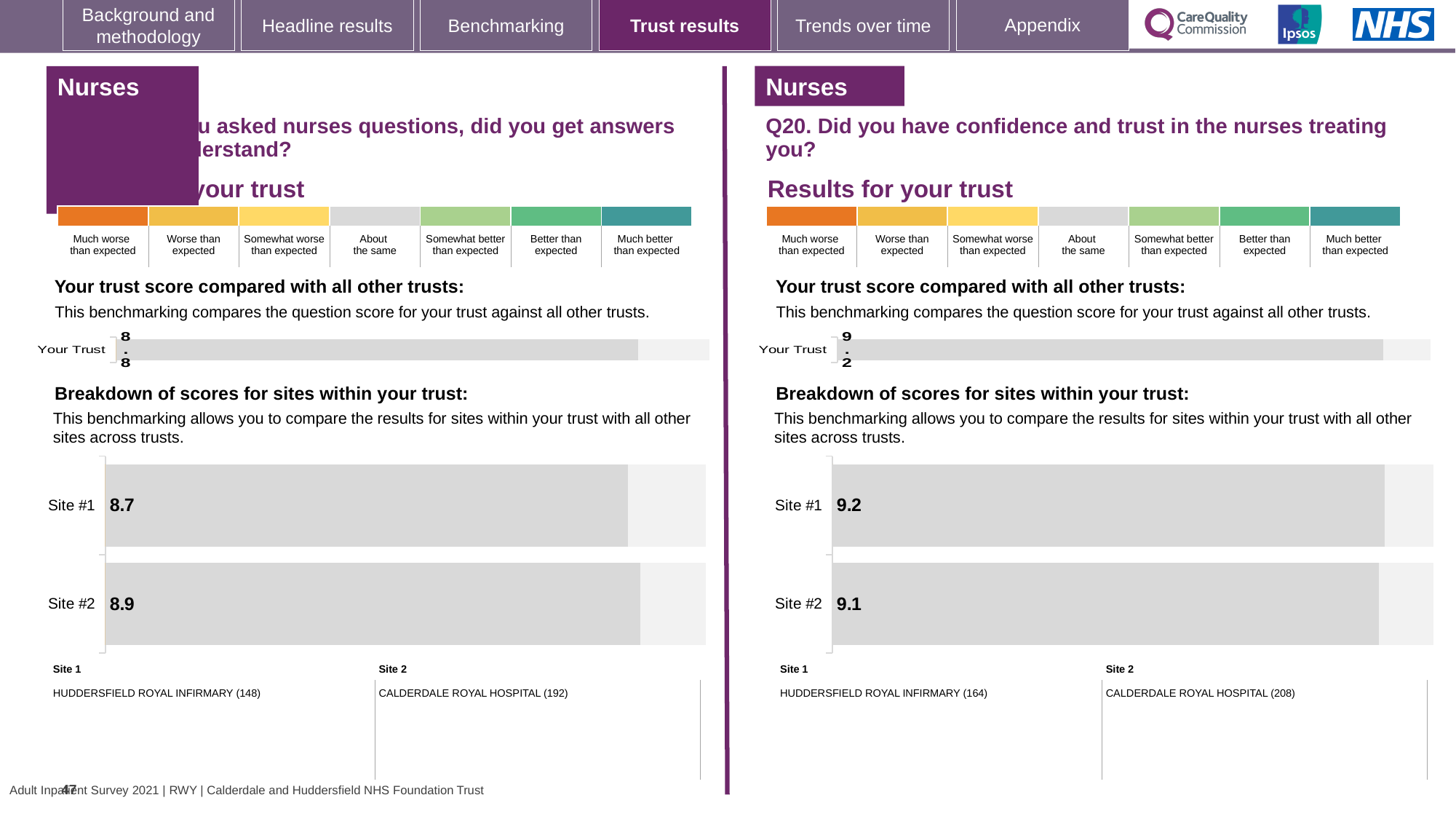
On the right panel (Q20) 'Your trust score compared with all other trusts' chart, what is the score for Your Trust? 9.2 On the left panel's 'Breakdown of scores for sites within your trust' chart, what is the score for Site #1? 8.7 How many sites are shown on the right panel (Q20) site breakdown chart? 2 On the left panel's 'Your trust score compared with all other trusts' chart, what is the score for Your Trust? 8.8 On the right panel (Q20) site breakdown chart, what is the difference between the Site #1 and Site #2 scores? 0.1 What type of chart is used for the site breakdown on the left panel? Bar chart On the left panel's site breakdown chart, what is the difference between the Site #2 and Site #1 scores? 0.2 On the right panel (Q20) 'Breakdown of scores for sites within your trust' chart, what is the score for Site #1? 9.2 On the left panel's 'Breakdown of scores for sites within your trust' chart, what is the score for Site #2? 8.9 On the right panel (Q20) site breakdown chart, which site has the lower score? Site #2 On the left panel's site breakdown chart, which site has the higher score? Site #2 On the right panel (Q20) 'Breakdown of scores for sites within your trust' chart, what is the score for Site #2? 9.1